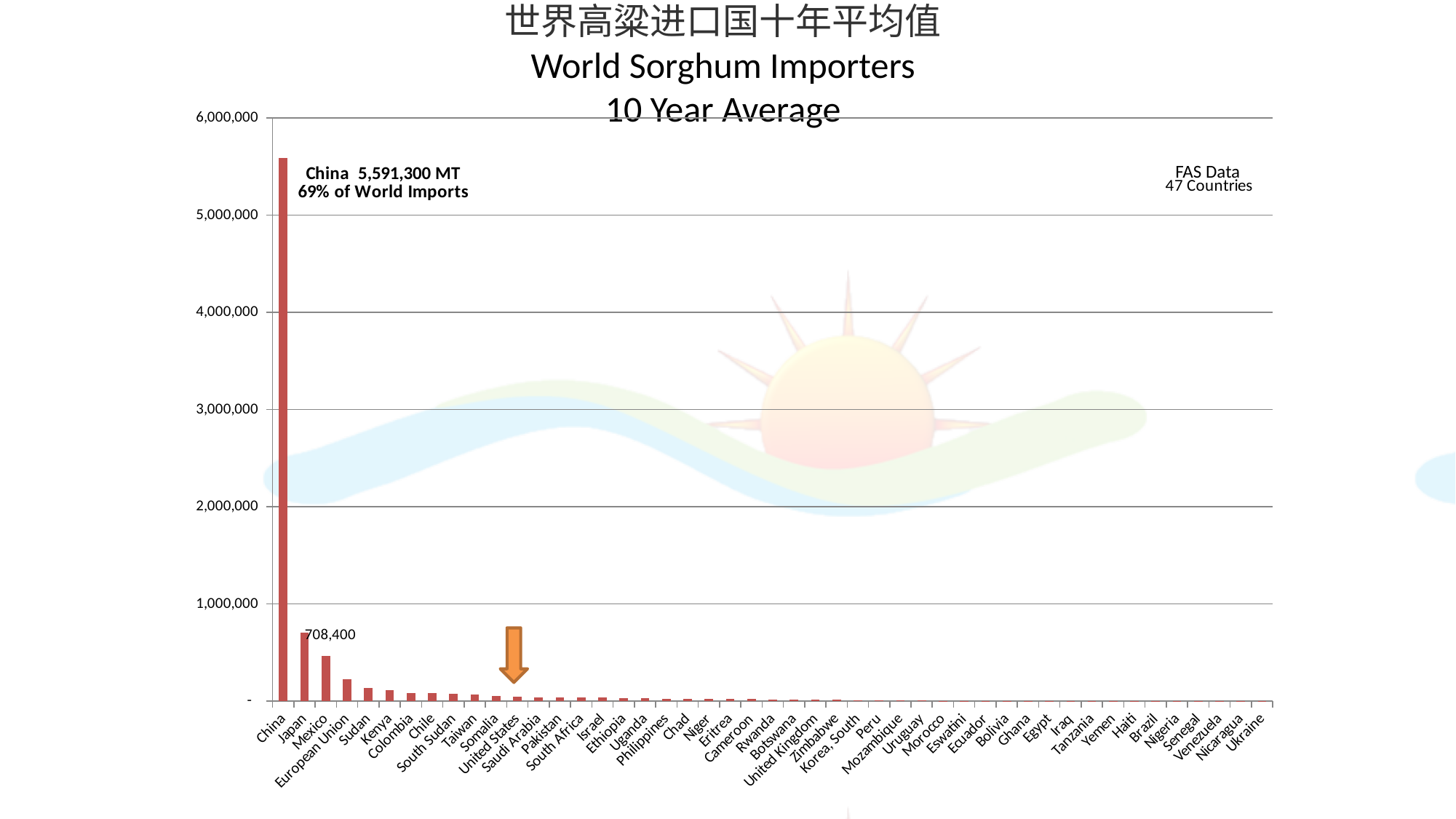
Is the value for China greater or less than 5,000,000? greater What is the difference between China's and Japan's labeled import values? 4,882,900 Do the import values rise or fall moving from left to right along the x axis? Fall What data source is cited on the chart? FAS Data Which country has the highest 10-year average sorghum imports? China What share of world sorghum imports does China account for, according to the slide? 69% What kind of chart is shown on the slide? Bar chart Which has larger sorghum imports, Japan or Mexico? Japan What is the 10-year average sorghum import value shown for China? 5,591,300 MT Is the value for Mexico greater or less than 1,000,000? less How many countries are plotted on the chart? 47 What value is labeled on the bar for Japan? 708,400